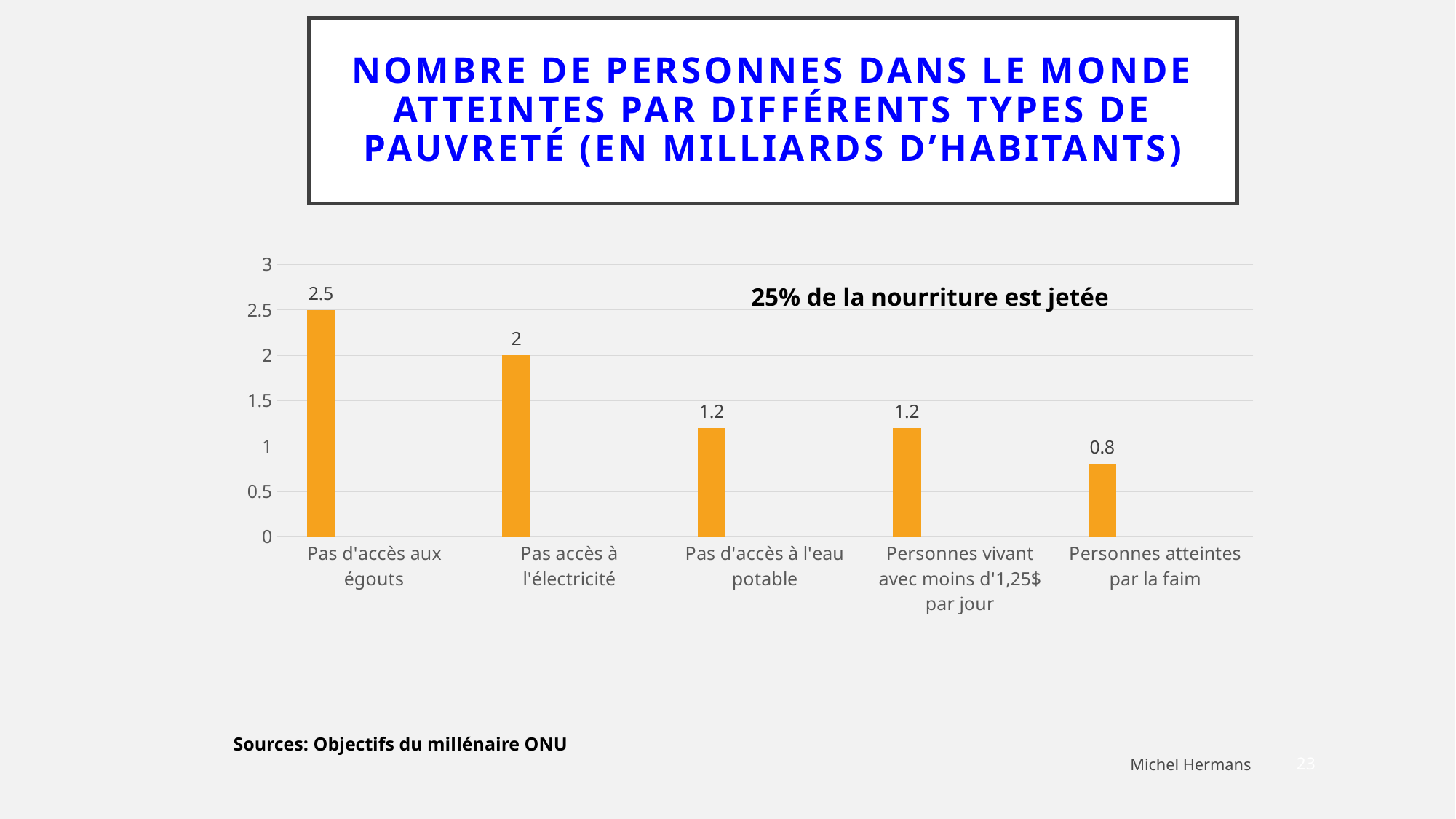
Which category has the lowest value? Personnes atteintes par la faim What is the difference between the values for "Pas d'accès aux égouts" and "Pas accès à l'électricité"? 0.5 Which is larger: the value for "Pas accès à l'électricité" or the value for "Pas d'accès à l'eau potable"? Pas accès à l'électricité What is the value for "Personnes atteintes par la faim"? 0.8 What is the value for "Pas d'accès aux égouts"? 2.5 What text annotation is printed inside the chart area? 25% de la nourriture est jetée What is the difference between the values for "Pas accès à l'électricité" and "Personnes atteintes par la faim"? 1.2 What is the value for "Pas d'accès à l'eau potable"? 1.2 How many categories are shown in the chart? 5 What kind of chart is shown on the slide? Bar chart Which category has the highest value? Pas d'accès aux égouts What is the value for "Pas accès à l'électricité"? 2